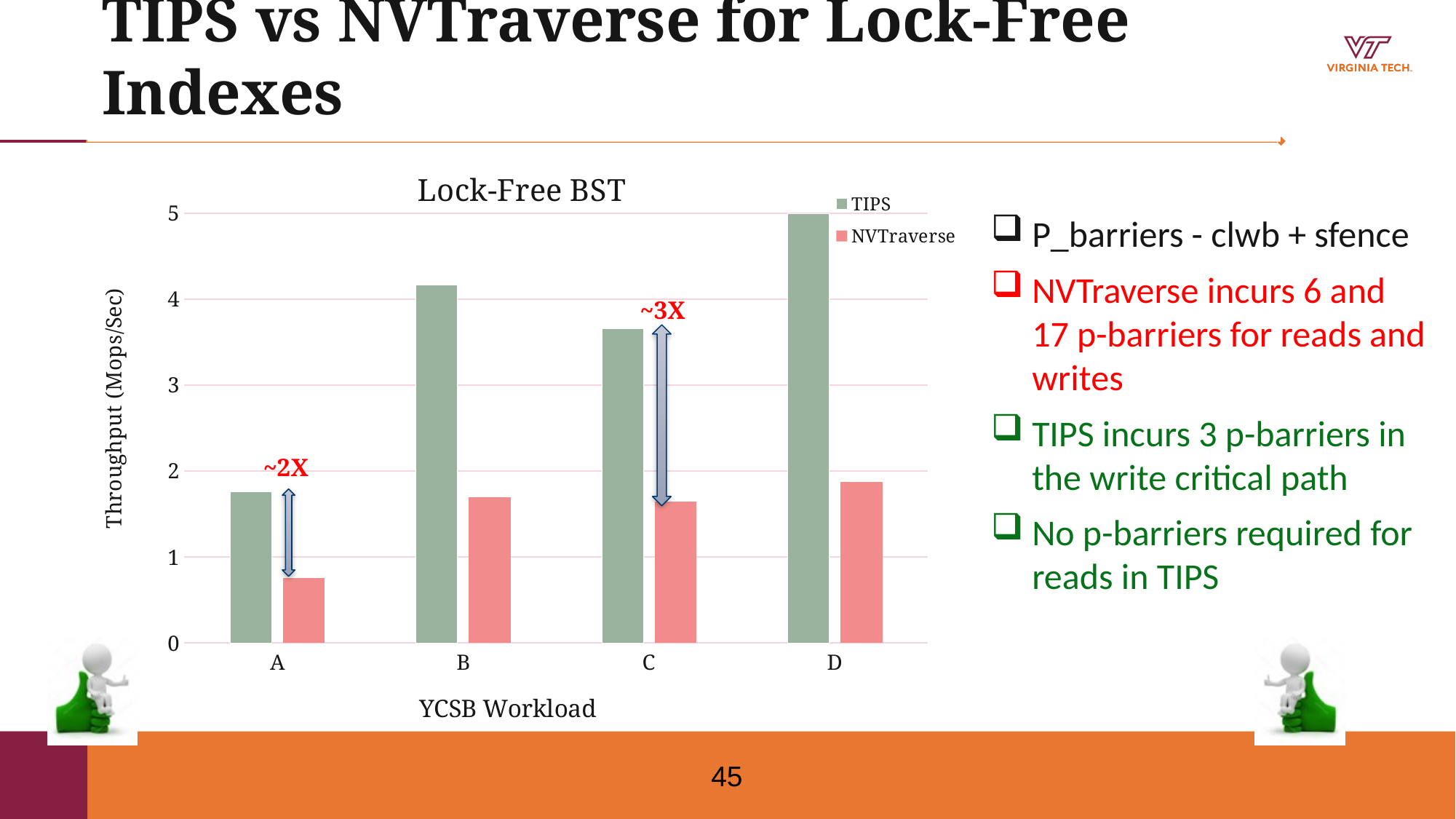
Is the NVTraverse throughput for workload A greater or less than 1? less What annotation is shown above the bars for workload C? ~3X For which YCSB workload is the TIPS throughput lowest? A Is the TIPS throughput for workload C greater or less than 3? greater Is the TIPS throughput for workload B greater or less than 4? greater For which YCSB workload is the TIPS throughput highest? D How many series does the legend list in the Lock-Free BST chart? 2 For workload B, which has the higher throughput, TIPS or NVTraverse? TIPS How many YCSB workloads are shown on the x axis of the Lock-Free BST chart? 4 For which YCSB workload is the NVTraverse throughput lowest? A What is the label of the y axis in the Lock-Free BST chart? Throughput (Mops/Sec) What type of chart is shown on the slide? bar chart